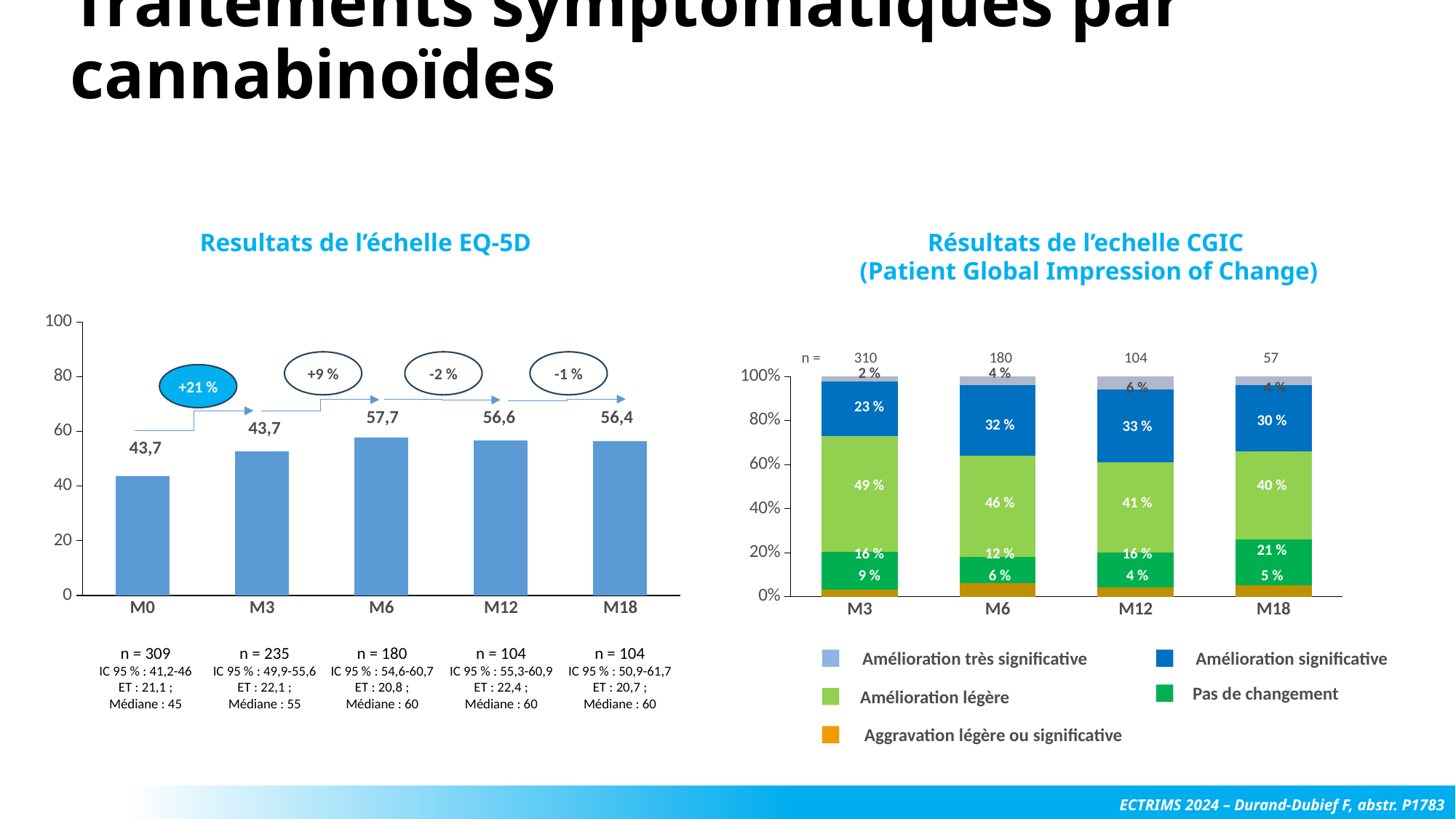
In the 'Résultats de l'echelle CGIC' chart, is the 'Amélioration significative' share larger at M3 or at M6? M6 In the 'Résultats de l'echelle CGIC' chart, what is the share of 'Amélioration significative' at M12? 33 % What kind of chart is the 'Resultats de l'échelle EQ-5D' chart on the left? Bar chart In the 'Resultats de l'échelle EQ-5D' chart, what is the value at M18? 56,4 In the 'Resultats de l'échelle EQ-5D' chart, what is the difference between the values at M6 and M12? 1,1 In the 'Résultats de l'echelle CGIC' chart, what is the n value shown above the M18 bar? 57 In the 'Résultats de l'echelle CGIC' chart, what is the share of 'Amélioration légère' at M3? 49 % In the 'Resultats de l'échelle EQ-5D' chart, what percentage change is annotated between M0 and M3? +21 % In the 'Resultats de l'échelle EQ-5D' chart, what is the value at M6? 57,7 How many series does the legend of the 'Résultats de l'echelle CGIC' chart list? 5 How many time points are shown on the x axis of the 'Resultats de l'échelle EQ-5D' chart? 5 In the 'Resultats de l'échelle EQ-5D' chart, which time point has the highest value? M6